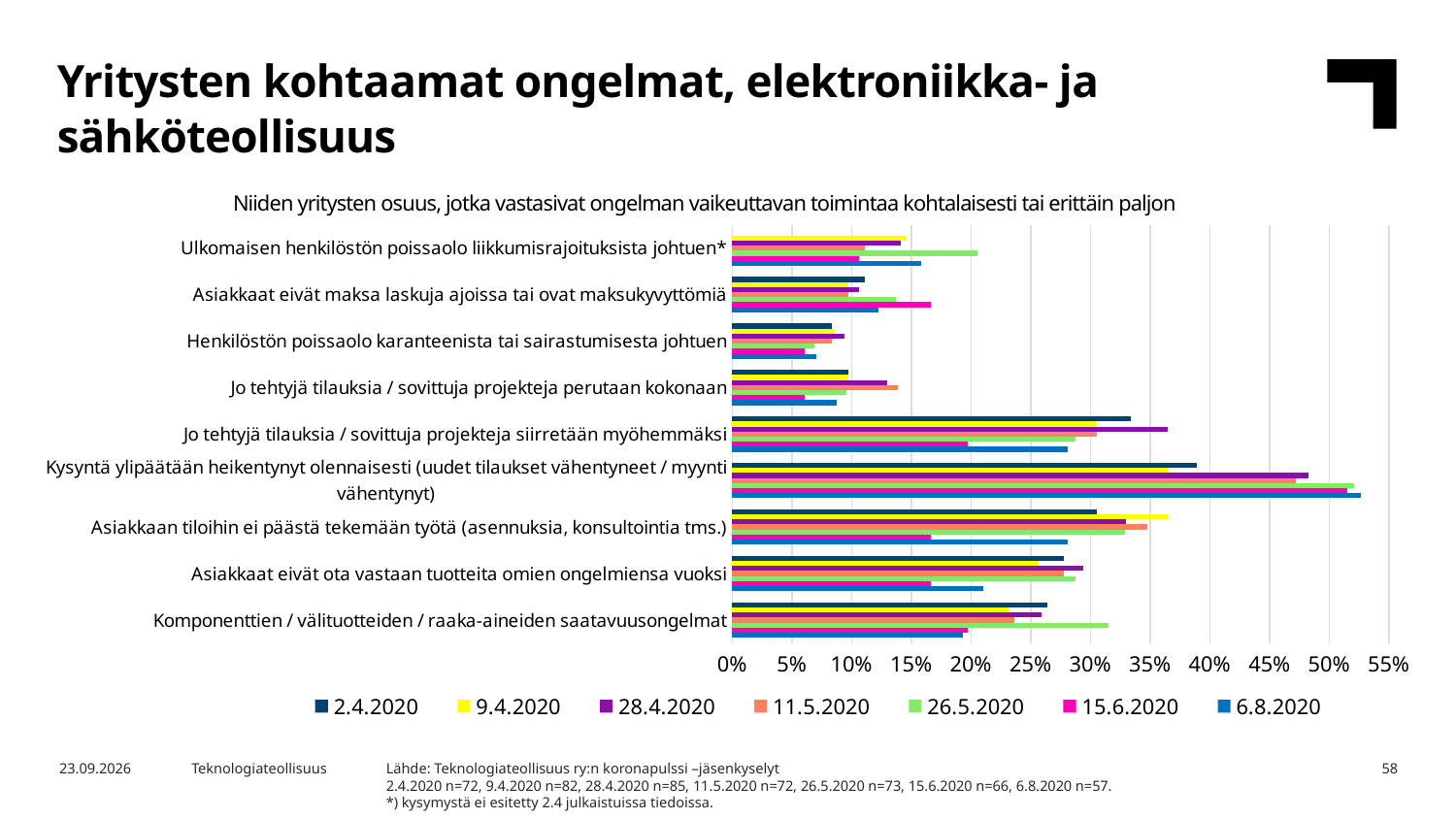
Which category has the highest value in the 6.8.2020 series? Kysyntä ylipäätään heikentynyt olennaisesti (uudet tilaukset vähentyneet / myynti vähentynyt) What kind of chart is shown on the slide? Bar chart Is the value for 'Henkilöstön poissaolo karanteenista tai sairastumisesta johtuen' in the 2.4.2020 series greater or less than 10%? less Is the value for 'Komponenttien / välituotteiden / raaka-aineiden saatavuusongelmat' in the 26.5.2020 series greater or less than 30%? greater How many problem categories are listed on the chart? 9 How many series does the legend list? 7 For 'Komponenttien / välituotteiden / raaka-aineiden saatavuusongelmat', which is larger: the 26.5.2020 value or the 6.8.2020 value? 26.5.2020 What is the first series listed in the legend? 2.4.2020 Is the value for 'Kysyntä ylipäätään heikentynyt olennaisesti' in the 6.8.2020 series greater or less than 50%? greater For 'Asiakkaan tiloihin ei päästä tekemään työtä', which is larger: the 9.4.2020 value or the 15.6.2020 value? 9.4.2020 What is the subtitle shown above the chart? Niiden yritysten osuus, jotka vastasivat ongelman vaikeuttavan toimintaa kohtalaisesti tai erittäin paljon